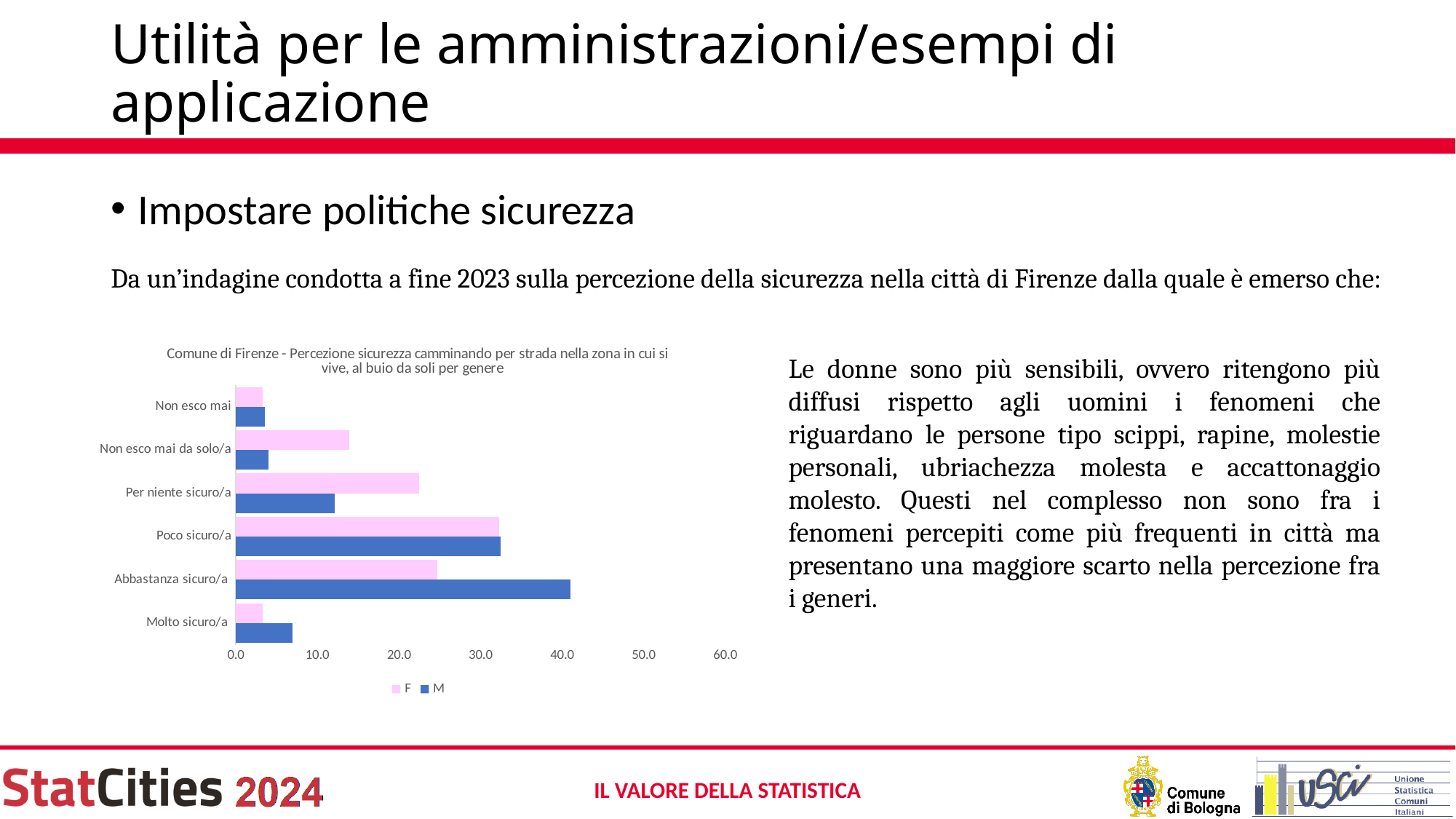
Is the value for M in the category Molto sicuro/a greater or less than 10.0? less What kind of chart is shown on the slide? bar chart For the category Non esco mai da solo/a, which series has the larger value, F or M? F How many categories are shown on the vertical axis of the chart? 6 Is the value for M in the category Abbastanza sicuro/a greater or less than 30.0? greater Is the value for F in the category Poco sicuro/a greater or less than 30.0? greater For the F series, which category has the highest value? Poco sicuro/a How many series does the chart legend list? 2 For the category Abbastanza sicuro/a, which series has the larger value, F or M? M For the M series, which category has the highest value? Abbastanza sicuro/a Which colour represents the F series in the chart? pink